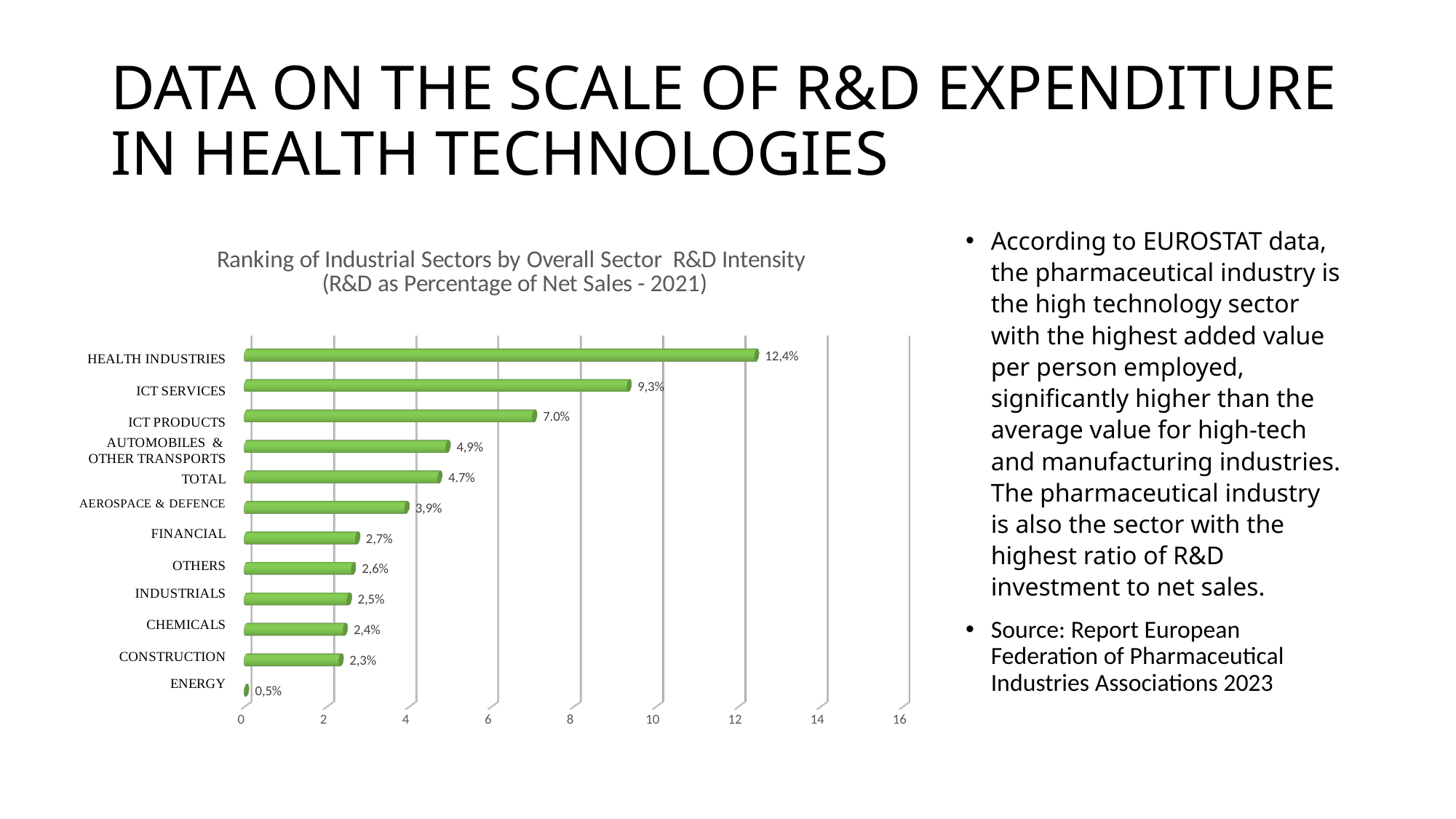
What value is shown for ICT SERVICES? 9,3% How many sectors (categories) are plotted in the chart? 12 Which sector has the lowest R&D intensity in the chart? ENERGY Which sector has the highest R&D intensity in the chart? HEALTH INDUSTRIES What year is referenced in the chart title? 2021 Is the value for ICT SERVICES greater or less than 10? less What value is shown for AEROSPACE & DEFENCE? 3,9% What value is shown for the TOTAL category? 4.7% What is the R&D intensity value shown for HEALTH INDUSTRIES? 12,4% What type of chart is shown on the slide? Bar chart Which has a larger value, ICT PRODUCTS or AUTOMOBILES & OTHER TRANSPORTS? ICT PRODUCTS What is the difference between the values for HEALTH INDUSTRIES and ICT SERVICES? 3,1%